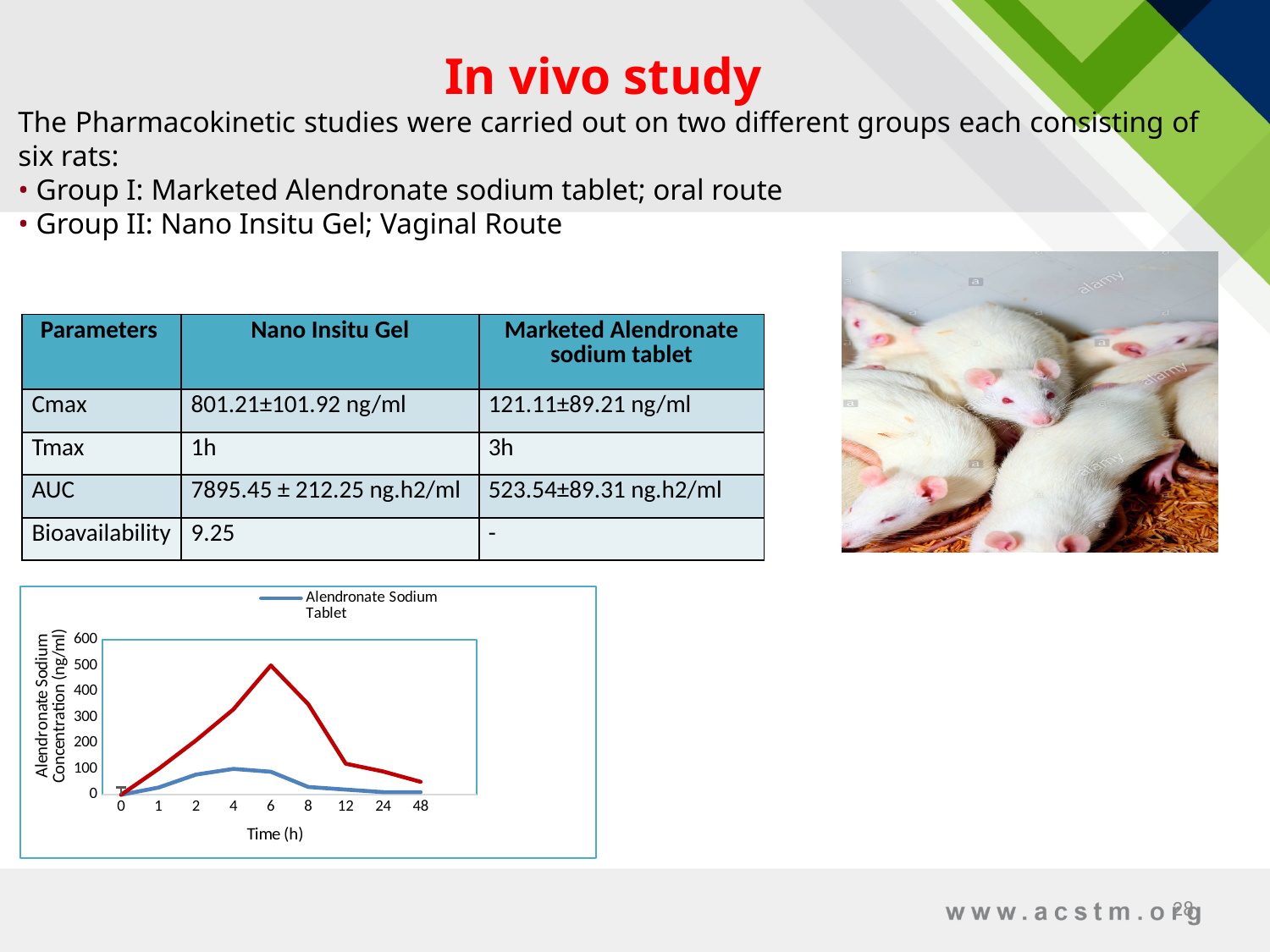
How many time points are marked on the chart's x axis? 9 What kind of chart is shown on the slide? line chart Is the value of the red line at 48 h greater or less than 100? less Is the highest value of the blue Alendronate Sodium Tablet line greater or less than 200? less Between 6 h and 48 h, does the red line rise or fall? fall At which time (h) does the red line reach its highest value? 6 Is the peak value of the red line greater or less than 400? greater What is the label of the chart's x axis? Time (h) At 6 h, which line is higher, the red line or the blue Alendronate Sodium Tablet line? the red line What series name appears in the chart's legend? Alendronate Sodium Tablet How many series does the chart's legend list? 1